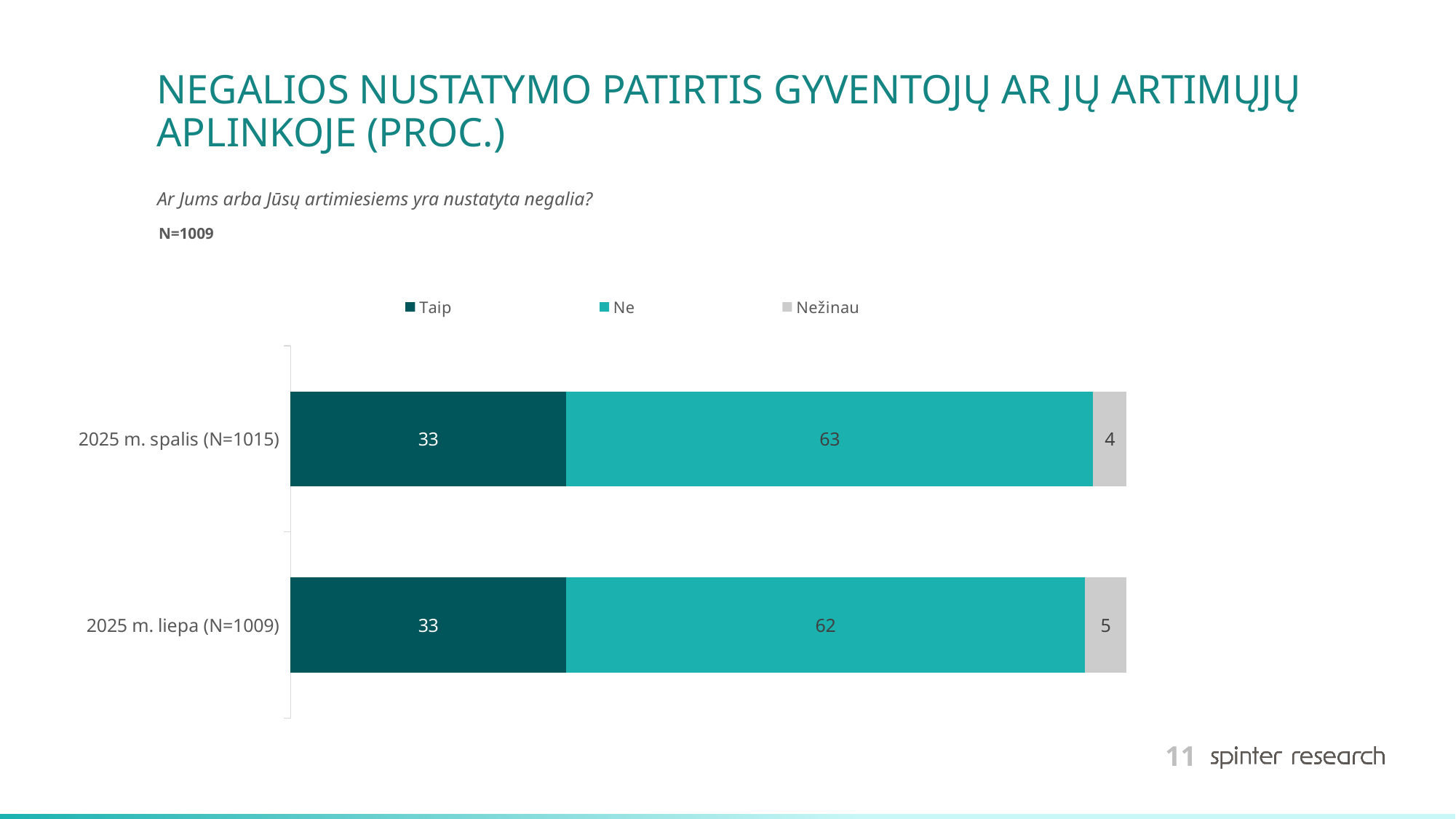
Which is larger: the "Nežinau" value for 2025 m. liepa (N=1009) or for 2025 m. spalis (N=1015)? 2025 m. liepa (N=1009) What is the value for "Nežinau" in the 2025 m. liepa (N=1009) bar? 5 How many series does the legend list? 3 What is the value for "Nežinau" in the 2025 m. spalis (N=1015) bar? 4 What is the total of the 2025 m. spalis (N=1015) stacked bar? 100 Which series has the smallest value in the 2025 m. liepa (N=1009) bar? Nežinau How many categories (bars) are shown in the chart? 2 What is the value for "Taip" in the 2025 m. spalis (N=1015) bar? 33 What is the value for "Ne" in the 2025 m. liepa (N=1009) bar? 62 Which series has the largest value in the 2025 m. spalis (N=1015) bar? Ne What is the difference between the "Ne" values for 2025 m. spalis (N=1015) and 2025 m. liepa (N=1009)? 1 What kind of chart is shown on the slide? Stacked bar chart